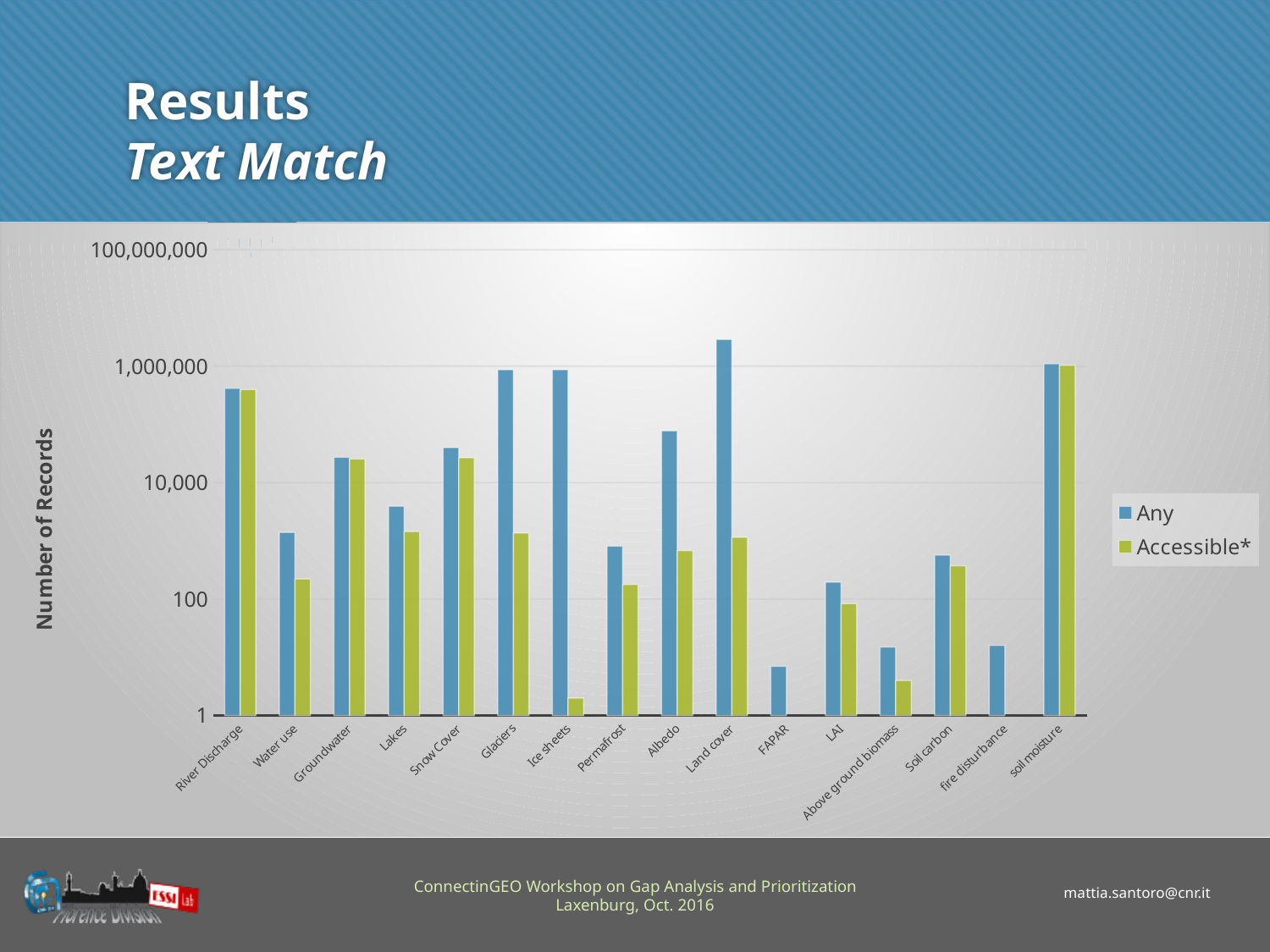
Which category has the lowest value for the Any series? FAPAR What is the title of the vertical axis? Number of Records Is the Any value for Land cover greater or less than 1,000,000? greater Is the Any value for Water use greater or less than 10,000? less What kind of chart is shown on the slide? bar chart For Ice sheets, which is larger: the Any value or the Accessible* value? Any Is the Any value for Albedo greater or less than 10,000? greater How many series does the legend list? 2 Which category has the highest value for the Any series? Land cover Which has a larger Any value: Albedo or Permafrost? Albedo How many categories are shown along the x axis? 16